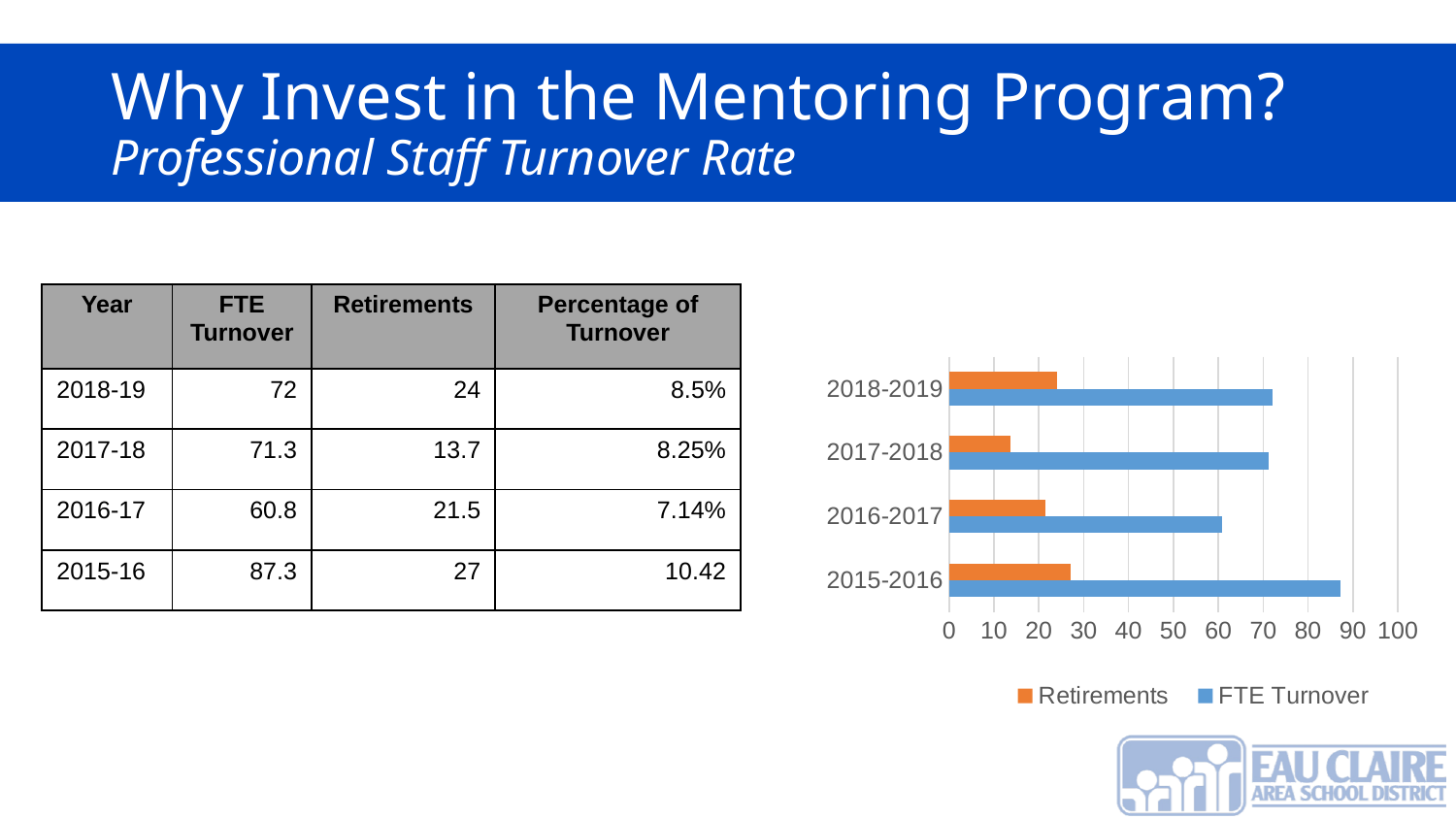
Which year has the highest FTE Turnover in the chart? 2015-2016 Which year has the lowest Retirements value in the chart? 2017-2018 Which colour represents the Retirements series in the chart? orange Is the Retirements value for 2017-2018 greater or less than 20? less What is the Retirements value for 2015-16 as printed on the slide? 27 How many series does the chart legend list? 2 Is the FTE Turnover value for 2015-2016 greater or less than 80? greater What is the FTE Turnover value for 2018-19 as printed on the slide? 72 Is the FTE Turnover value for 2016-2017 greater or less than 70? less How many year categories are plotted in the chart? 4 What kind of chart is shown on the slide? bar chart Which is larger in the chart: Retirements for 2018-2019 or Retirements for 2016-2017? Retirements for 2018-2019